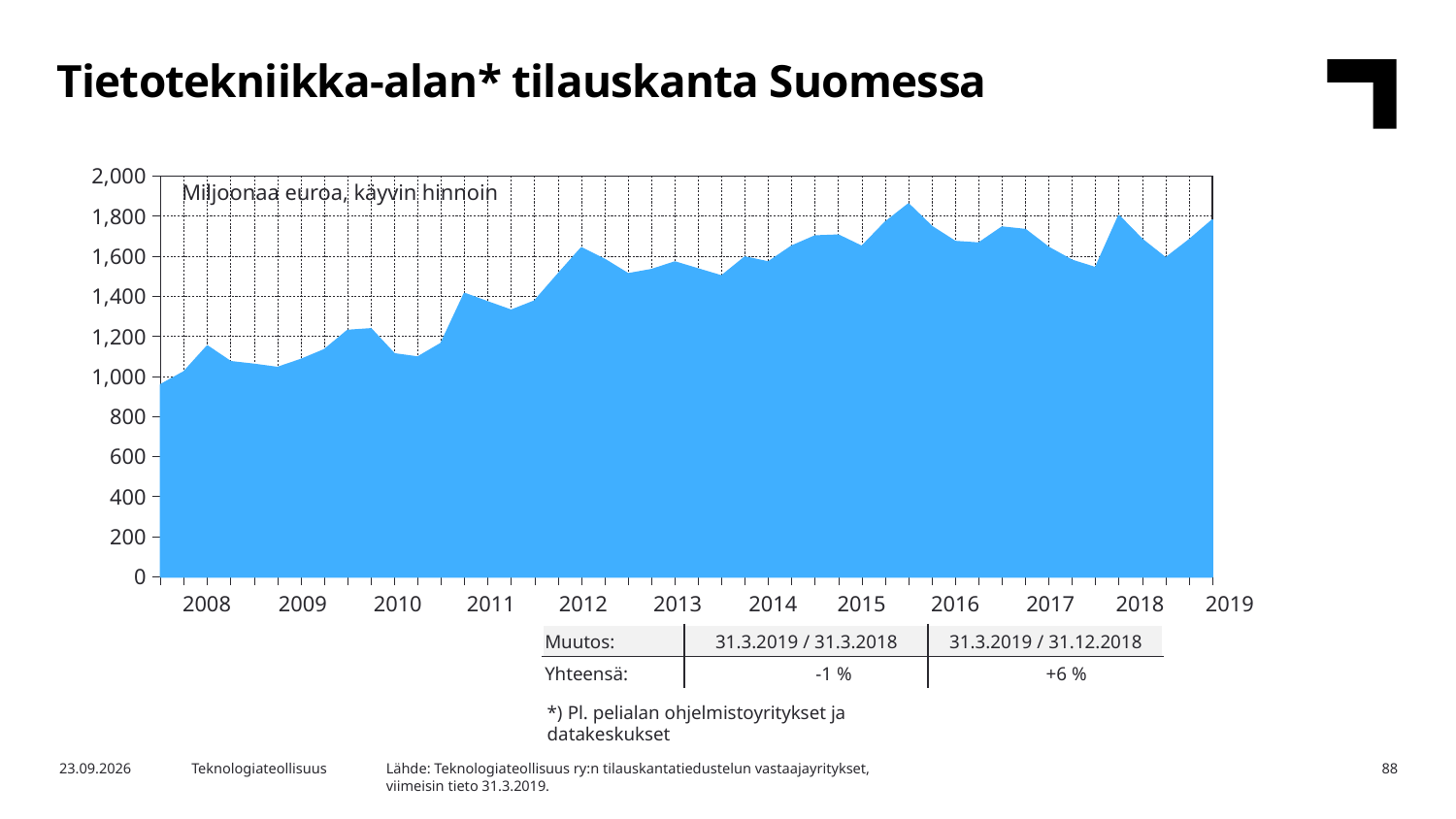
Is the value at the start of 2019 greater or less than 1,600? greater Is the value at the start of 2009 greater or less than 1,200? less What is the title of the chart on the slide? Tietotekniikka-alan* tilauskanta Suomessa Overall, do the values rise or fall from 2008 to 2019? Rise What unit is stated inside the chart area? Miljoonaa euroa, käyvin hinnoin According to the table below the chart, what is the change (Muutos) for 31.3.2019 / 31.3.2018? -1 % In which year is the plotted value at its lowest? 2008 Is the value at the start of 2012 greater or less than 1,400? greater According to the table below the chart, what is the change (Muutos) for 31.3.2019 / 31.12.2018? +6 % What kind of chart is shown on the slide? Area chart How many years are labelled on the x axis of the chart? 12